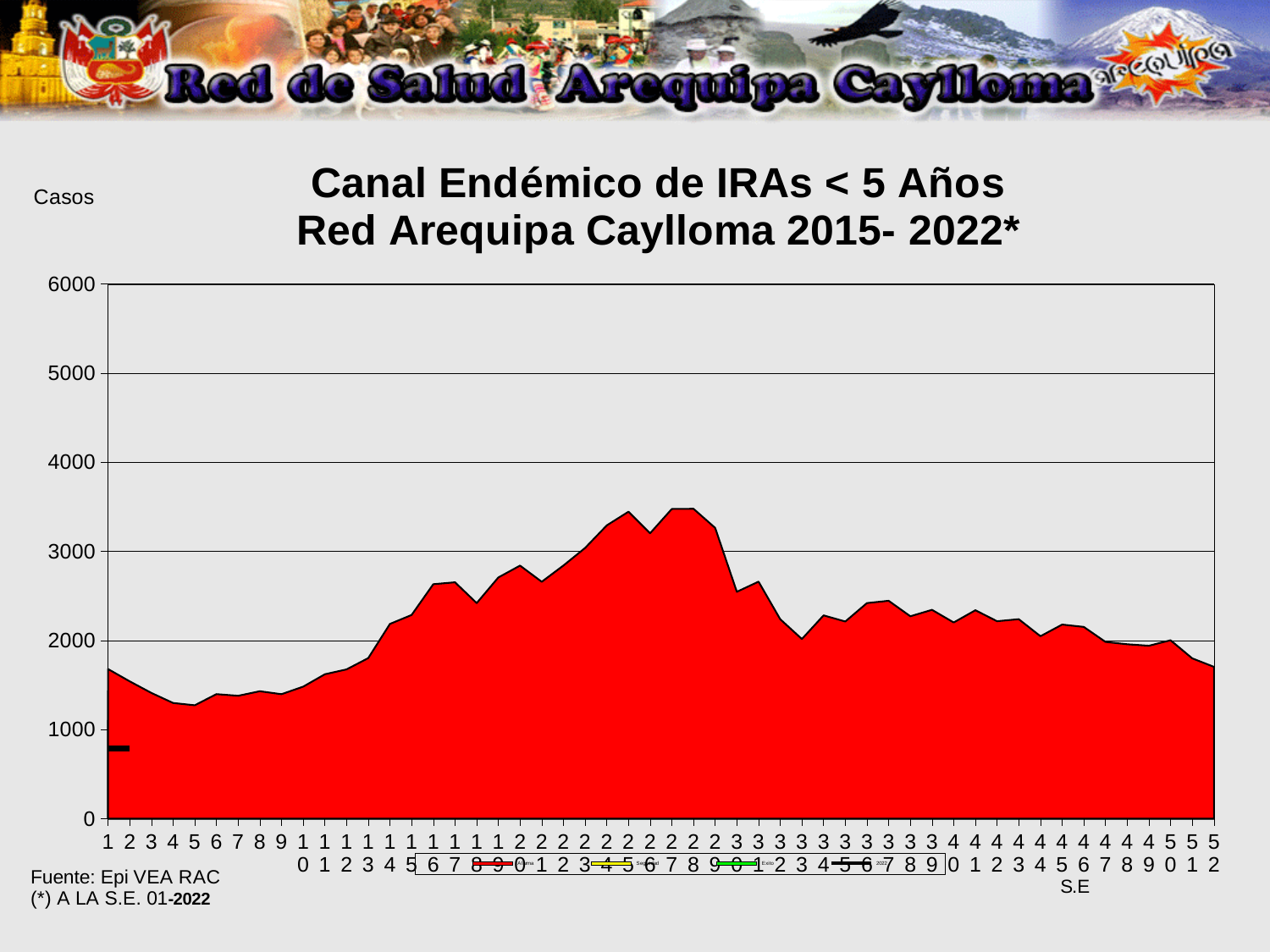
Which week has the larger value, week 27 or week 5? Week 27 Is the value for week 27 greater or less than 3000? greater Do the values generally rise or fall from week 28 to week 52? Fall How many epidemiological weeks (S.E.) are shown along the x axis? 52 Is the value for week 5 greater or less than 2000? less What label is shown on the vertical axis of the chart? Casos What kind of chart is shown on the slide? Area chart What is the title of the chart? Canal Endémico de IRAs < 5 Años Red Arequipa Caylloma 2015- 2022* Is the value for week 52 greater or less than 2000? less Do the values generally rise or fall from week 5 to week 27? Rise